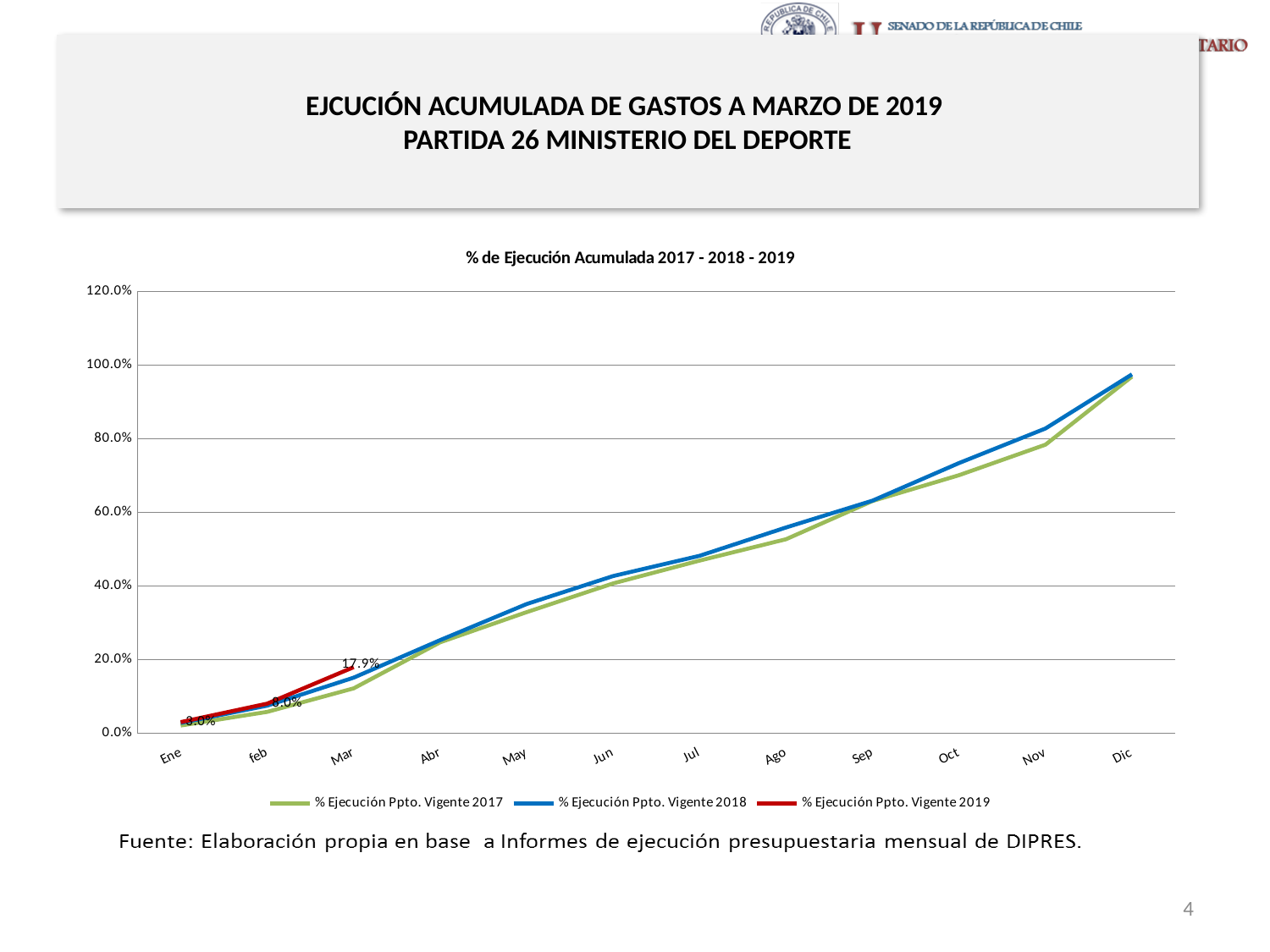
How many series does the legend list? 3 What kind of chart is shown on the slide? Line chart Do the values for % Ejecución Ppto. Vigente 2018 rise or fall from Ene to Dic? Rise Is the value for % Ejecución Ppto. Vigente 2018 in Dic greater or less than 80.0%? greater Is the value for % Ejecución Ppto. Vigente 2017 in Ago greater or less than 60.0%? less In Nov, which series has the higher value: % Ejecución Ppto. Vigente 2018 or % Ejecución Ppto. Vigente 2017? % Ejecución Ppto. Vigente 2018 What is the value for % Ejecución Ppto. Vigente 2019 in Feb? 8.0% In which month does the % Ejecución Ppto. Vigente 2019 series reach its highest value? Mar What is the value for % Ejecución Ppto. Vigente 2019 in Mar? 17.9% What is the difference between the 2019 values for Mar and Feb? 9.9 percentage points What is the value for % Ejecución Ppto. Vigente 2019 in Ene? 3.0% How many months are shown on the x axis? 12